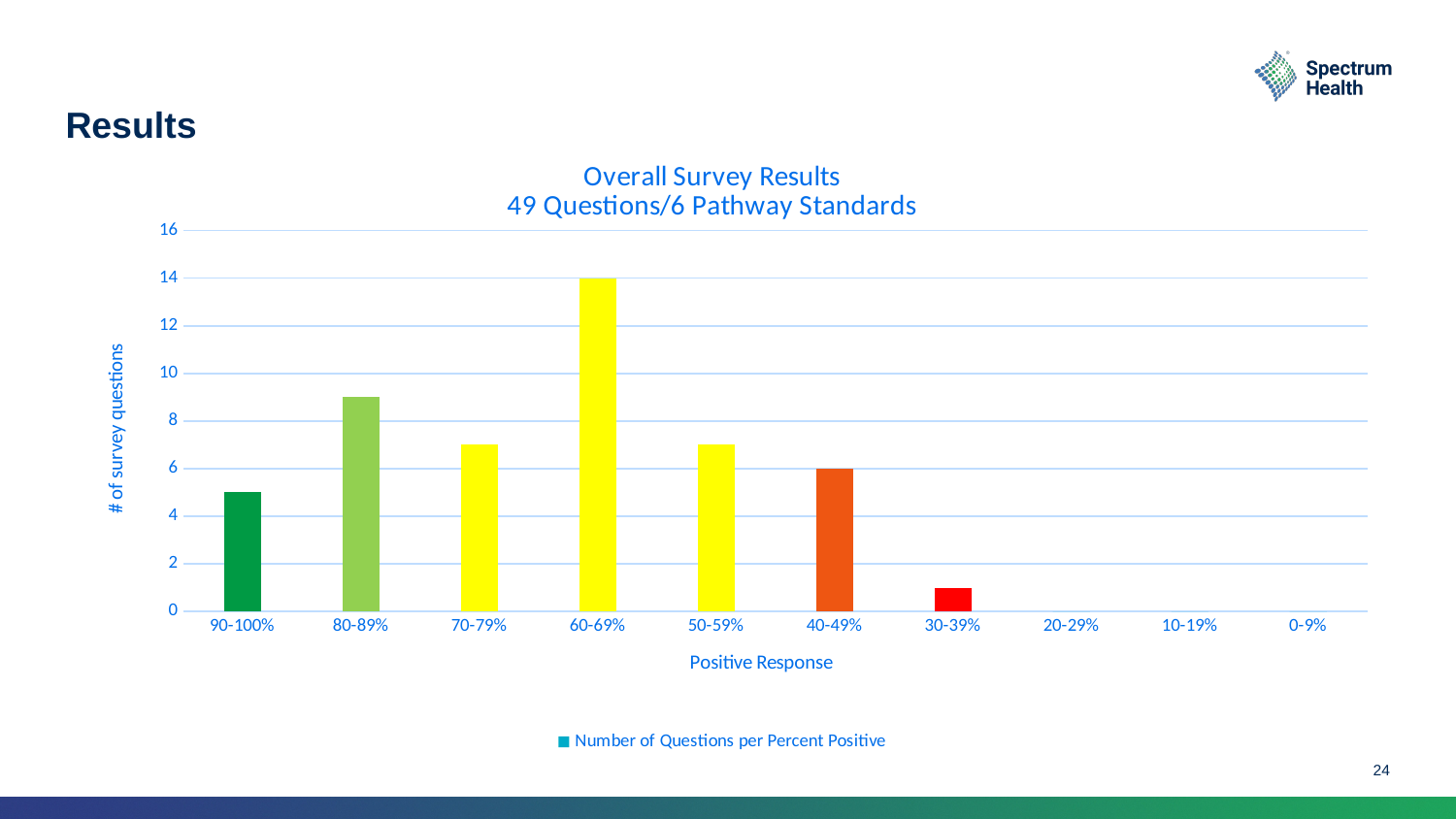
Is the value for 80-89% greater or less than 8? greater How many categories are shown on the x axis? 10 Which positive response category has the highest number of survey questions? 60-69% What is the difference between the values for 60-69% and 40-49%? 8 Which has more survey questions, 80-89% or 90-100%? 80-89% What is the number of survey questions for the 40-49% category? 6 What type of chart is shown on the slide? bar chart How many series does the legend list? 1 What is the label of the y axis? # of survey questions What is the title of the chart? Overall Survey Results 49 Questions/6 Pathway Standards Is the value for 30-39% greater or less than 2? less What is the number of survey questions for the 60-69% category? 14